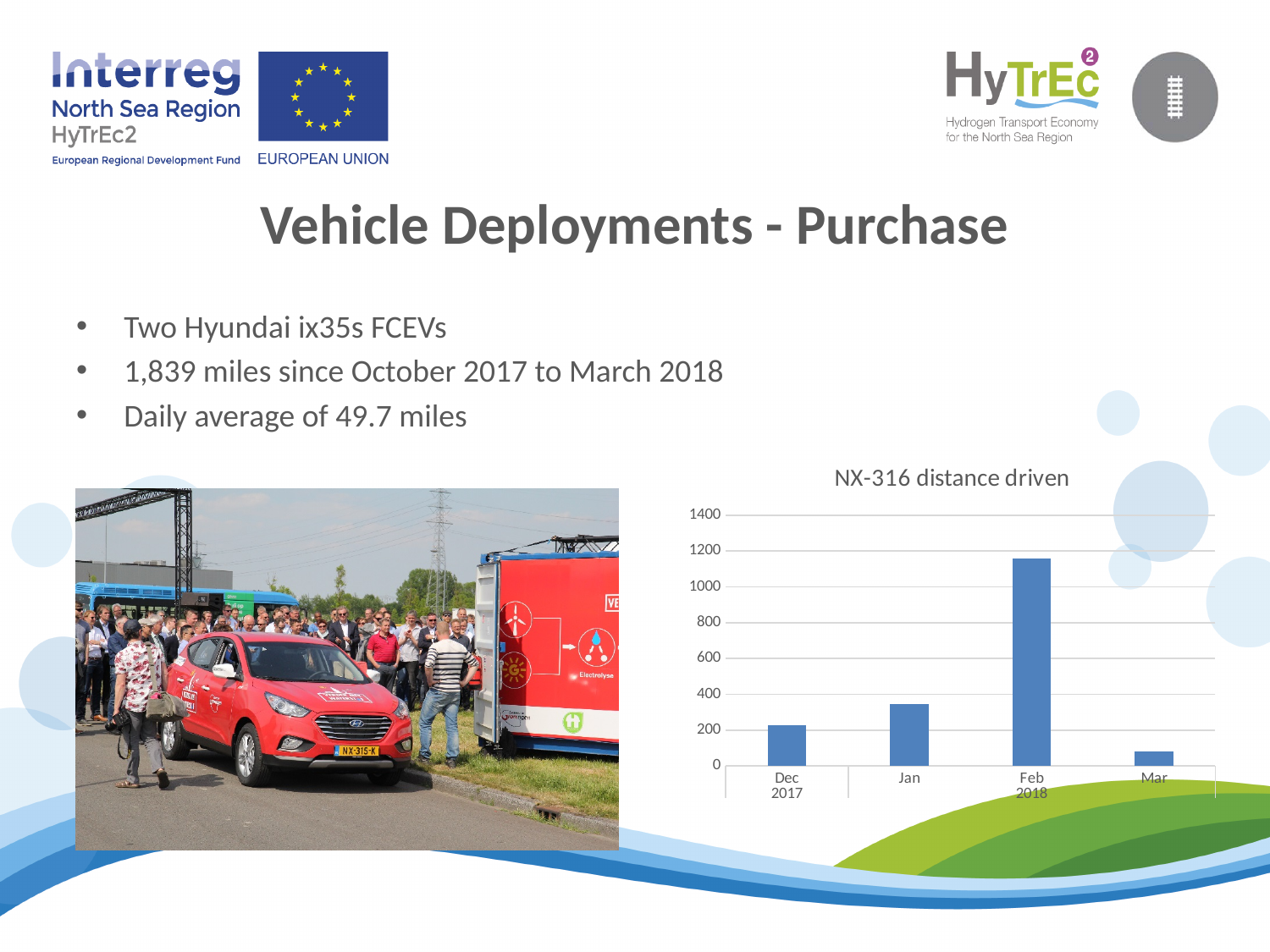
Is the value for Jan greater or less than 400? less Which is larger, the distance driven in Jan or in Dec 2017? Jan Is the value for Feb 2018 greater or less than 1000? greater Does the distance driven rise or fall from Feb 2018 to Mar? fall What is the title of the chart? NX-316 distance driven Is the value for Mar greater or less than 200? less Which month has the lowest distance driven in the chart? Mar What kind of chart is shown on the slide? bar chart How many months are plotted in the NX-316 distance driven chart? 4 What is the highest value shown on the vertical axis of the chart? 1400 Which month has the highest distance driven in the chart? Feb 2018